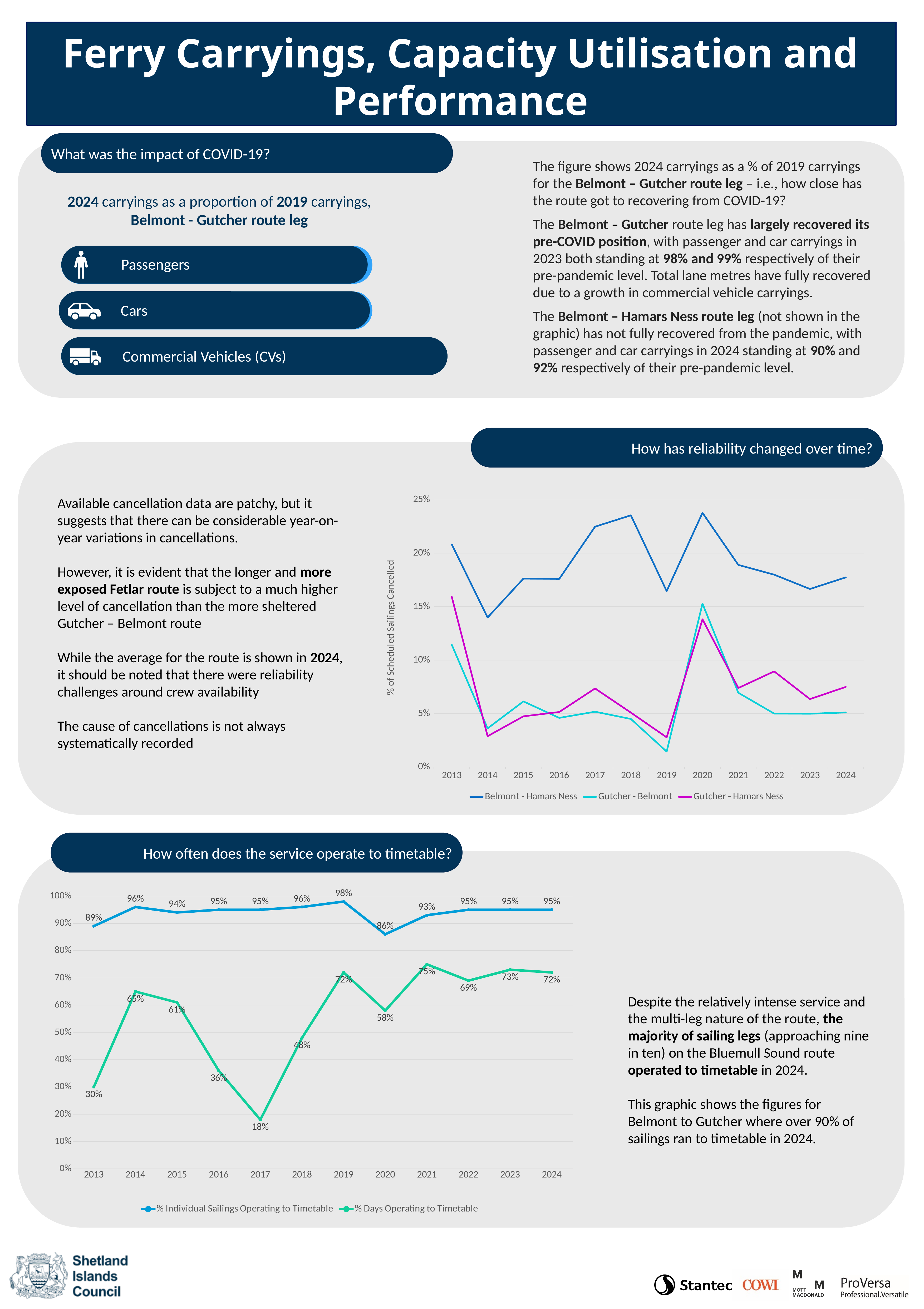
In the 'How has reliability changed over time?' chart, is the value for Gutcher - Belmont in 2019 greater or less than 5%? less In the 'How often does the service operate to timetable?' chart, which year has the highest value for % Days Operating to Timetable? 2021 In the 'How has reliability changed over time?' chart, is the value for Belmont - Hamars Ness in 2020 greater or less than 20%? greater In the 'How has reliability changed over time?' chart, which year has the lowest value for Belmont - Hamars Ness? 2014 In the 'How often does the service operate to timetable?' chart, which year has the lowest value for % Individual Sailings Operating to Timetable? 2020 How many series does the legend of the 'How often does the service operate to timetable?' chart list? 2 In the 'How often does the service operate to timetable?' chart, what is the difference between % Individual Sailings Operating to Timetable and % Days Operating to Timetable in 2024? 23 percentage points In the 'How often does the service operate to timetable?' chart, what is the value for % Individual Sailings Operating to Timetable in 2019? 98% In the 'How often does the service operate to timetable?' chart, is the value for % Days Operating to Timetable higher in 2014 or in 2015? 2014 How many years are plotted on the x axis of the 'How has reliability changed over time?' chart? 12 In the 'How often does the service operate to timetable?' chart, what is the value for % Days Operating to Timetable in 2017? 18%